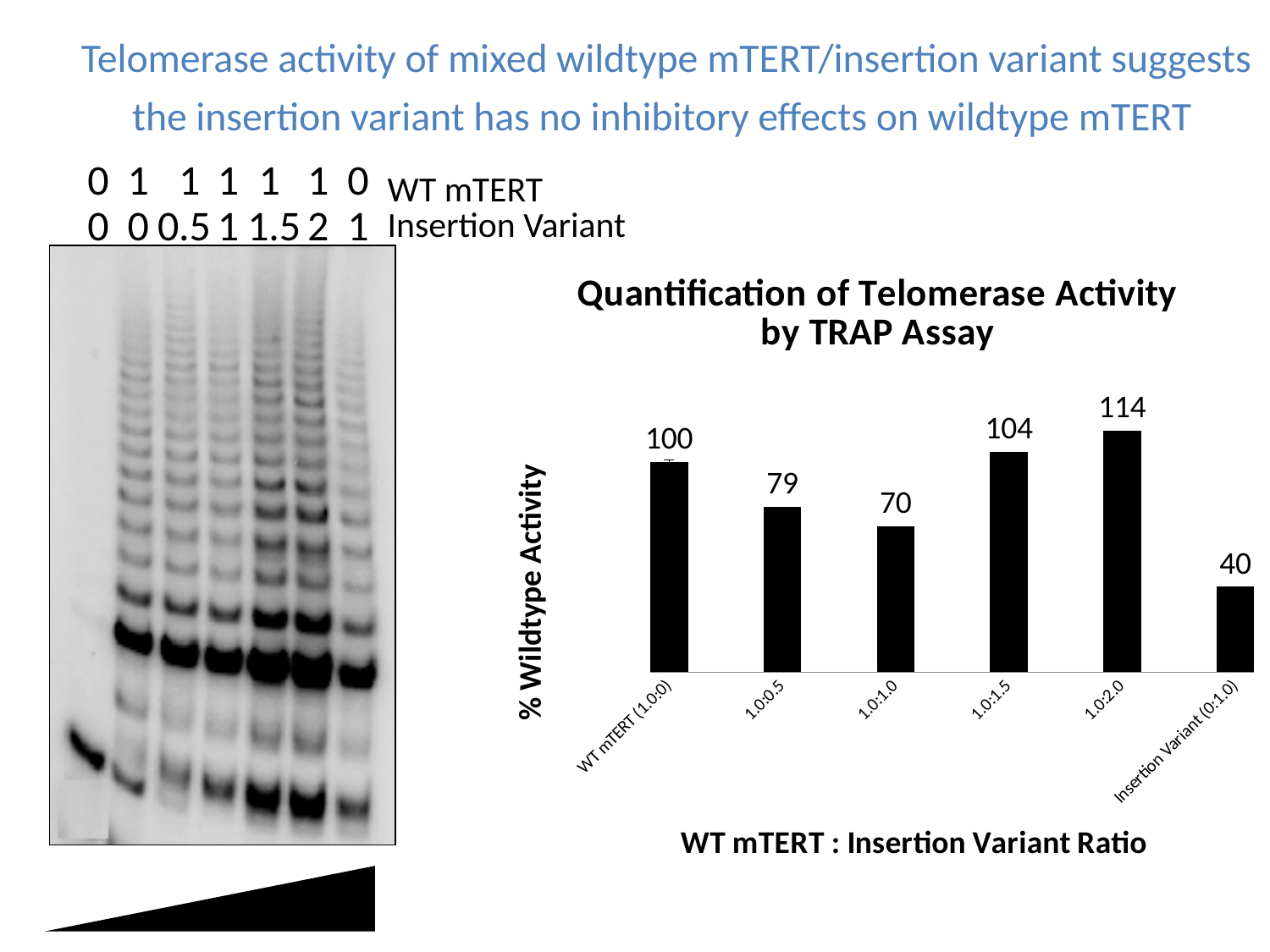
What is the x-axis title of the bar chart? WT mTERT : Insertion Variant Ratio What is the difference between the values for WT mTERT (1.0:0) and Insertion Variant (0:1.0) in the bar chart? 60 Which is larger in the bar chart, the value for 1.0:0.5 or the value for 1.0:1.0? 1.0:0.5 What is the value for the 1.0:0.5 ratio in the Quantification of Telomerase Activity by TRAP Assay chart? 79 What is the value for the 1.0:1.5 ratio in the bar chart? 104 Which category has the highest % Wildtype Activity in the bar chart? 1.0:2.0 How many bars are plotted in the Quantification of Telomerase Activity by TRAP Assay chart? 6 What is the y-axis title of the bar chart? % Wildtype Activity What kind of chart is the Quantification of Telomerase Activity by TRAP Assay chart? bar chart What is the difference between the values for 1.0:2.0 and 1.0:1.0 in the bar chart? 44 Which category has the lowest % Wildtype Activity in the bar chart? Insertion Variant (0:1.0) What is the value for Insertion Variant (0:1.0) in the bar chart? 40